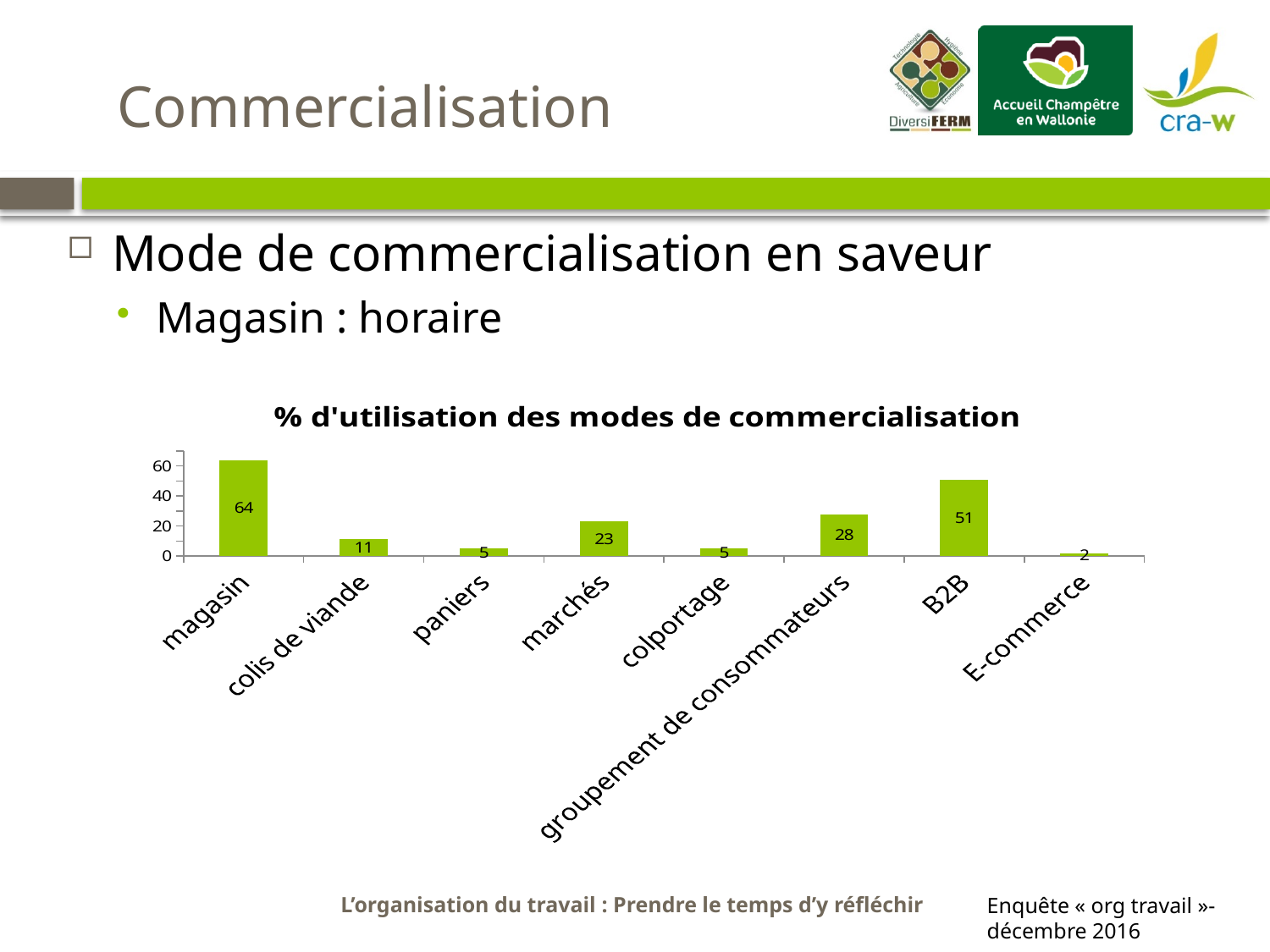
What is the difference between the values for magasin and B2B? 13 Is the value for B2B greater or less than 40? greater Which is larger, the value for marchés or the value for colis de viande? marchés How many categories are shown on the x axis? 8 What is the value for groupement de consommateurs? 28 What is the title of the chart? % d'utilisation des modes de commercialisation What kind of chart is this? bar chart Which category has the lowest value? E-commerce What is the value for B2B? 51 What is the difference between the values for groupement de consommateurs and marchés? 5 What is the value for magasin? 64 Which category has the highest value? magasin